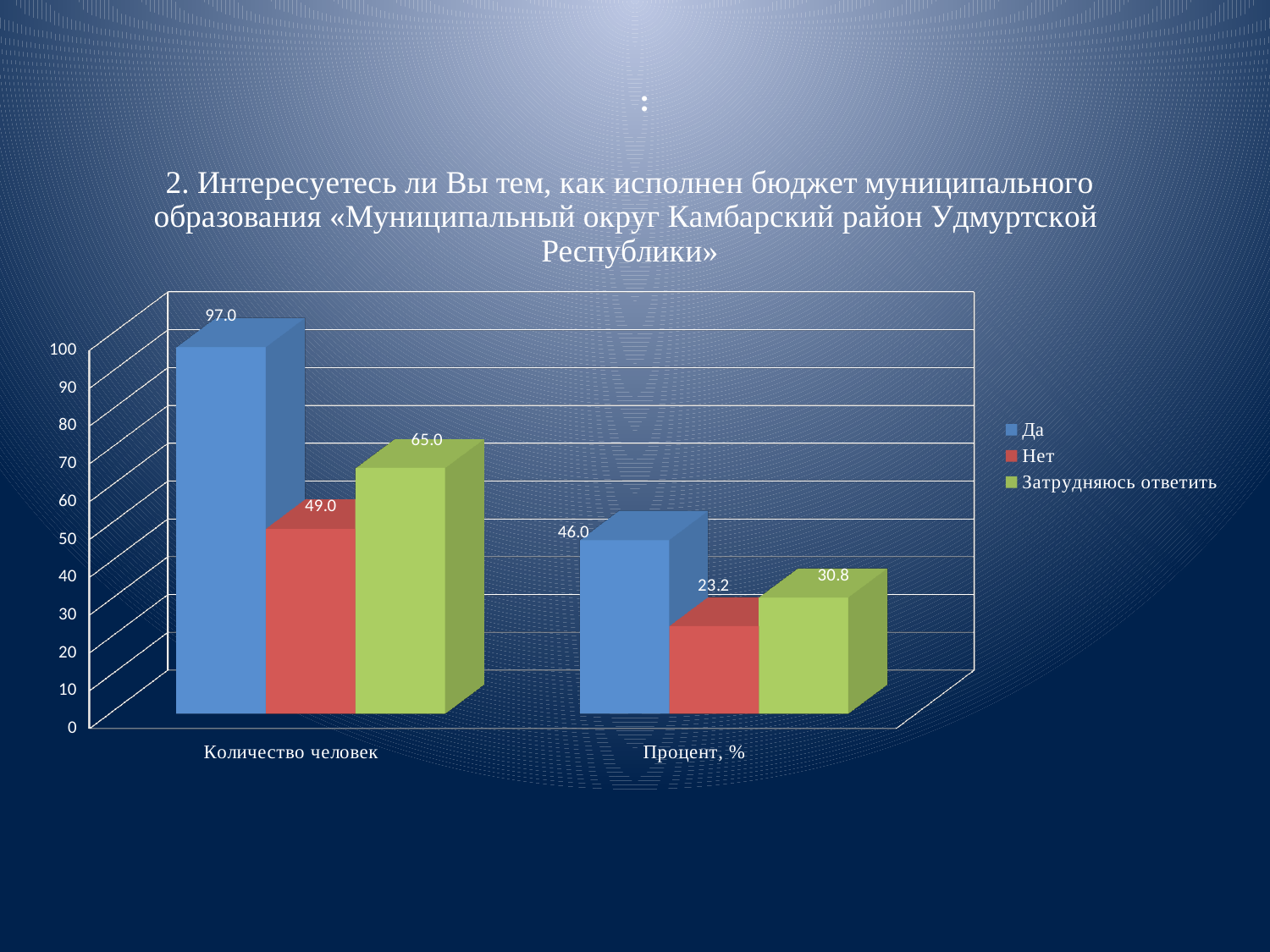
What is the value for "Затрудняюсь ответить" in the "Количество человек" category? 65.0 Which series has the highest value in the "Количество человек" category? Да Which series has the lowest value in the "Процент, %" category? Нет What is the value for "Нет" in the "Процент, %" category? 23.2 Which series is shown in red in the legend? Нет How many series does the legend list? 3 What kind of chart is shown on the slide? bar chart How many categories are shown on the x axis? 2 What is the difference between the "Да" and "Нет" values in the "Количество человек" category? 48.0 Which is larger: the "Нет" value or the "Затрудняюсь ответить" value in the "Количество человек" category? Затрудняюсь ответить What is the value for "Да" in the "Количество человек" category? 97.0 What is the difference between the "Затрудняюсь ответить" and "Нет" values in the "Процент, %" category? 7.6